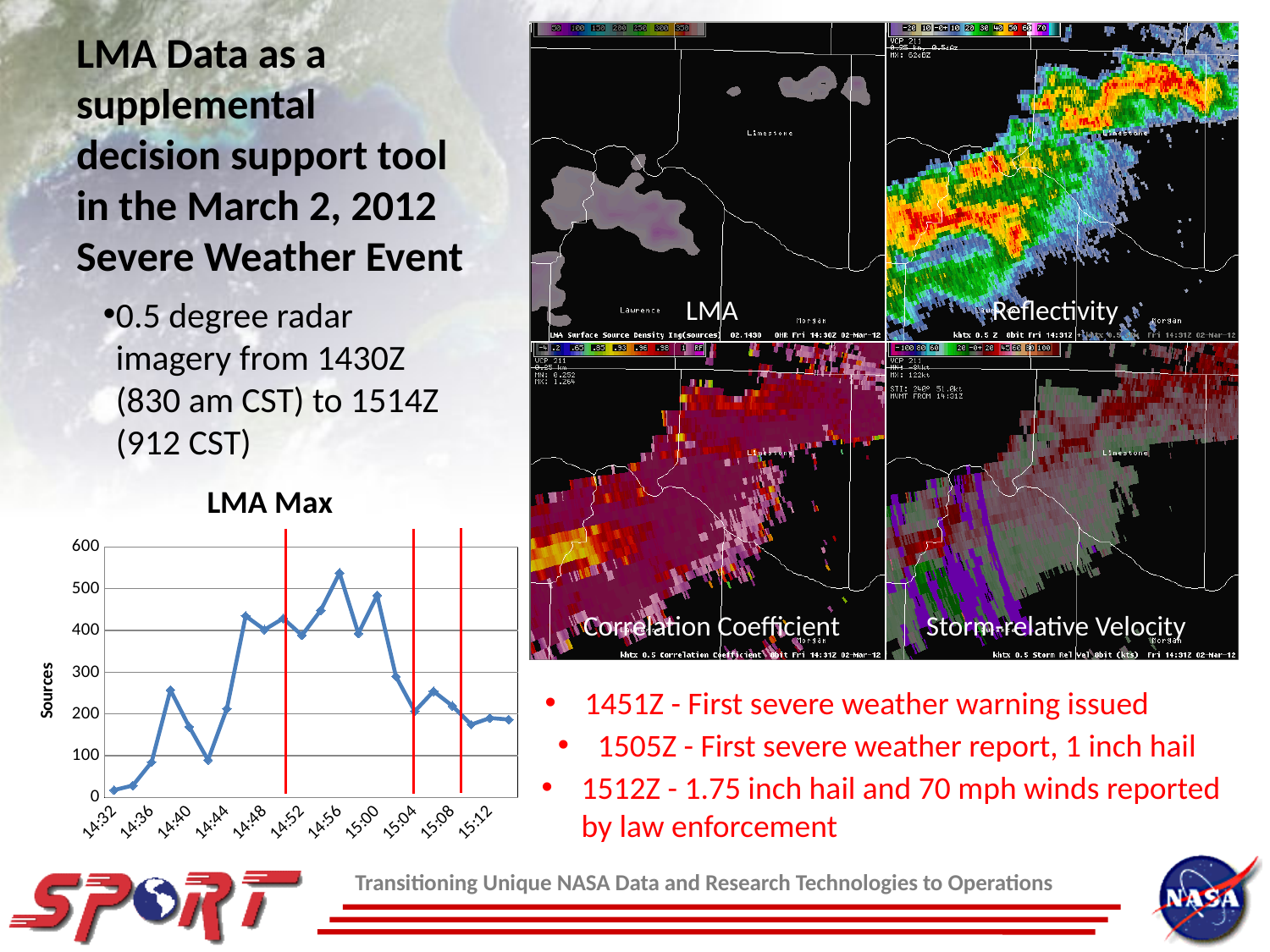
Do the values on the LMA Max chart generally rise or fall between 15:00 and 15:12? fall Is the value at 14:56 on the LMA Max chart greater or less than 500? greater Which is larger on the LMA Max chart, the value at 14:56 or the value at 15:00? 14:56 Is the value at 14:48 on the LMA Max chart greater or less than 300? greater At which time does the LMA Max chart show its lowest value? 14:32 What is the title of the chart on the slide? LMA Max At which time does the LMA Max chart reach its highest value? 14:56 Is the value at 14:32 on the LMA Max chart greater or less than 100? less How many time labels are shown on the x axis of the LMA Max chart? 11 What is the label on the vertical axis of the LMA Max chart? Sources What kind of chart is the LMA Max chart? line chart